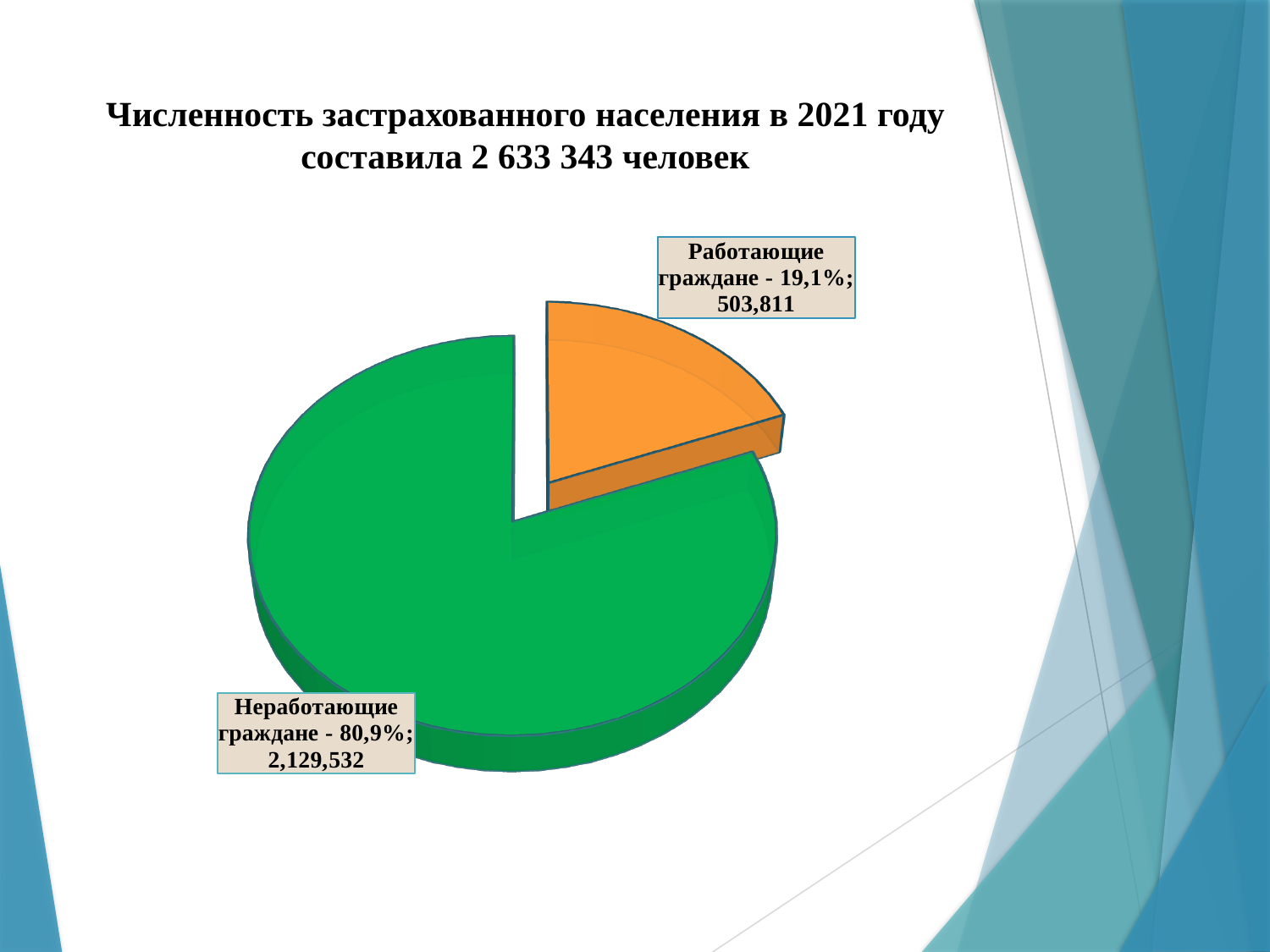
How many slices does the pie chart have? 2 What is the number of working citizens (Работающие граждане) shown on the chart? 503,811 Which is larger: the number of working citizens or the number of non-working citizens? Неработающие граждане Which category has the smallest slice of the pie? Работающие граждане According to the slide title, what was the total insured population in 2021? 2 633 343 человек What colour is the slice for working citizens (Работающие граждане)? Orange Which category has the largest slice of the pie? Неработающие граждане What kind of chart is shown on the slide? Pie chart What share of the pie do non-working citizens (Неработающие граждане) represent? 80,9% What share of the pie do working citizens (Работающие граждане) represent? 19,1% What is the number of non-working citizens (Неработающие граждане) shown on the chart? 2,129,532 What is the difference between the number of non-working citizens and the number of working citizens? 1,625,721